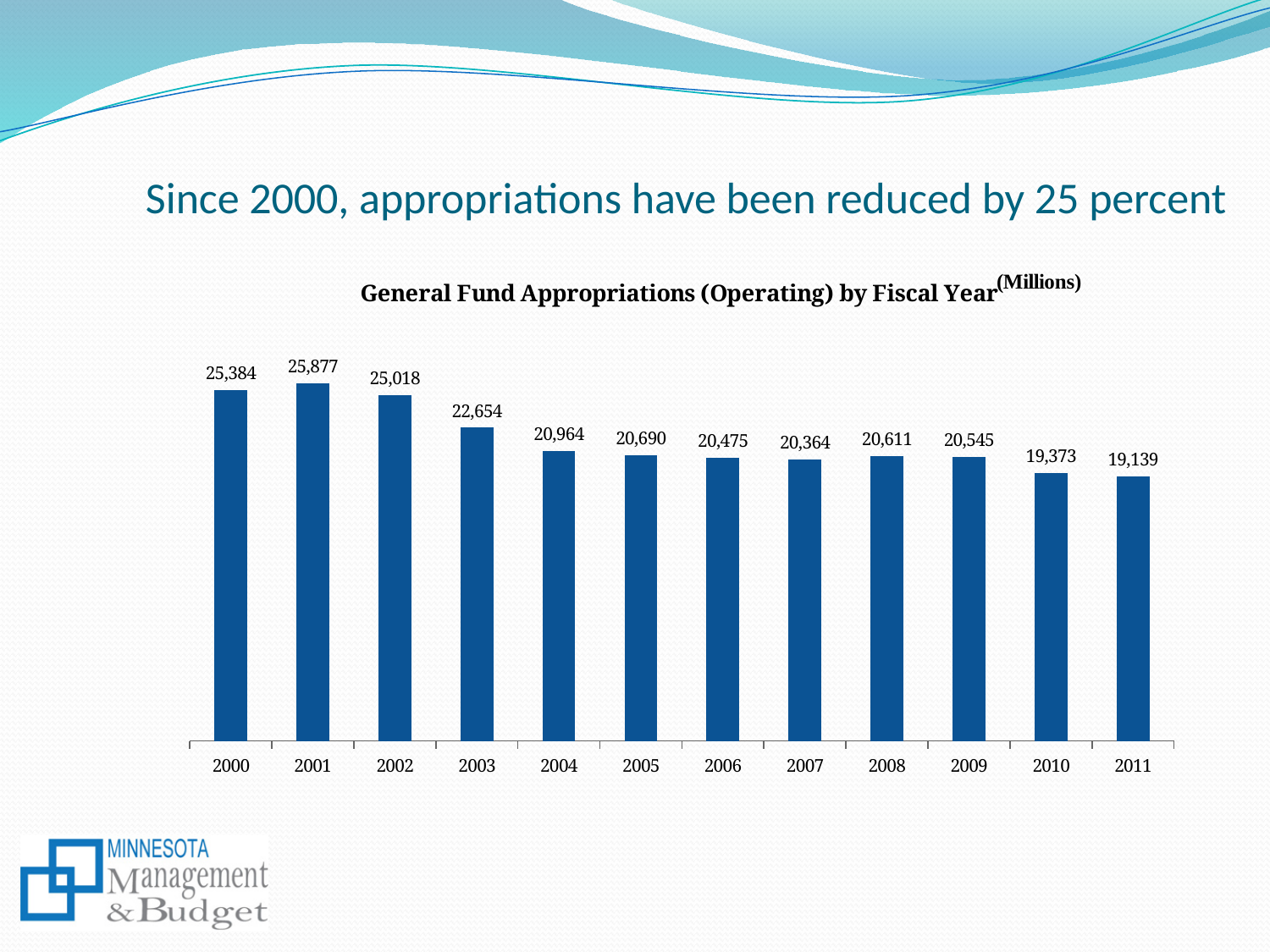
What kind of chart is shown on the slide? Bar chart What is the value shown for fiscal year 2011? 19,139 Which fiscal year has the lowest appropriation value? 2011 What is the value shown for fiscal year 2005? 20,690 What is the difference between the values for 2000 and 2011? 6,245 Which fiscal year has the highest appropriation value? 2001 Do the values generally rise or fall from 2000 to 2011? Fall What is the General Fund appropriation value for fiscal year 2000? 25,384 What is the difference between the values for 2002 and 2003? 2,364 How many fiscal years are shown on the chart? 12 Which is larger, the value for 2008 or the value for 2009? 2008 What is the title of the chart? General Fund Appropriations (Operating) by Fiscal Year (Millions)